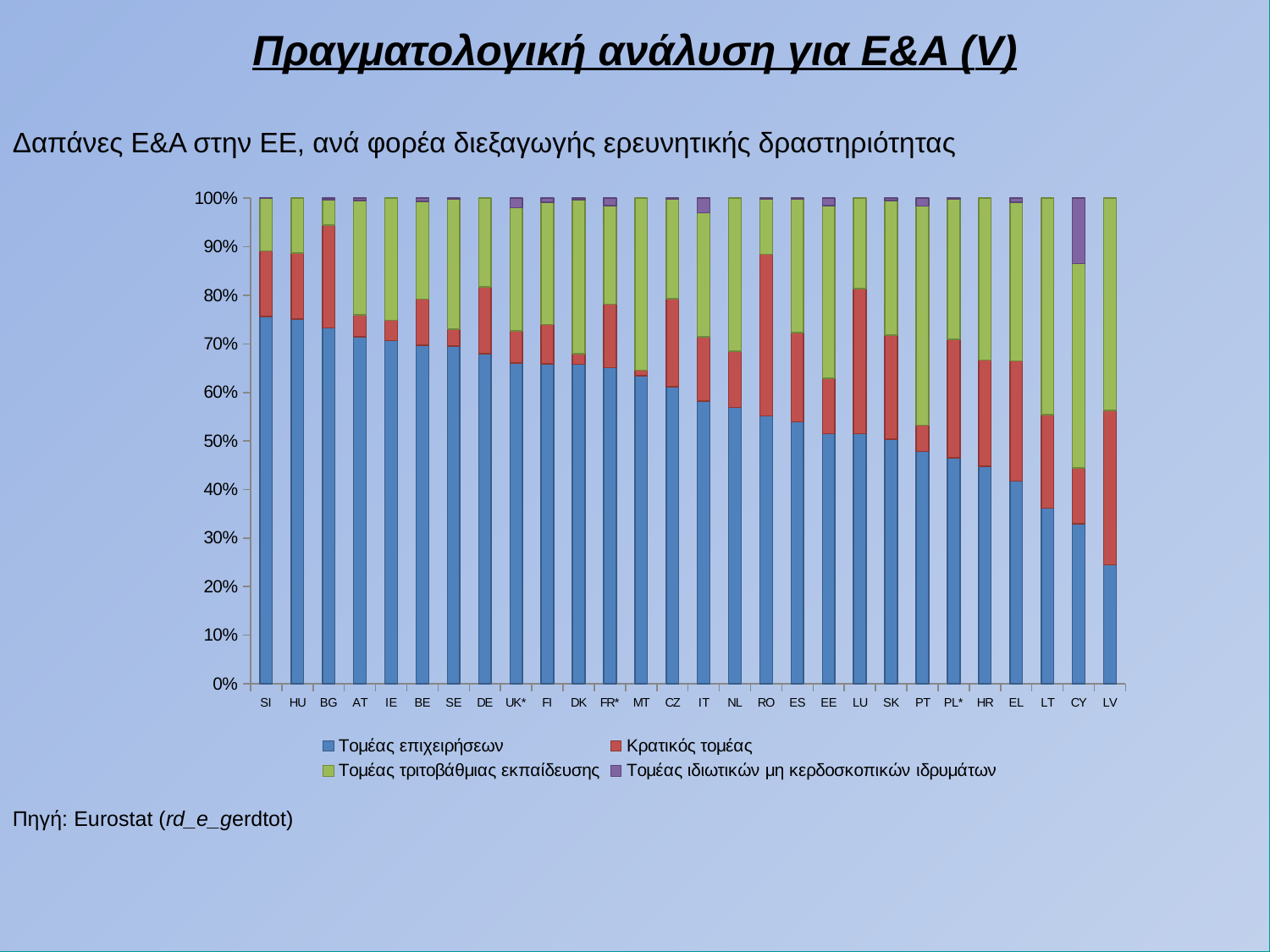
What type of chart is shown on the slide? Stacked bar chart Does the share for Τομέας επιχειρήσεων generally rise or fall from left to right along the x axis? fall Is the value for Τομέας επιχειρήσεων for LT greater or less than 40%? less Which colour represents Κρατικός τομέας in the legend? Red Which country has the lowest share for Τομέας επιχειρήσεων? LV What does each stacked bar total? 100% Which has a larger share for Τομέας επιχειρήσεων, SI or LV? SI Is the value for Τομέας επιχειρήσεων for SI greater or less than 70%? greater How many series does the legend list? 4 Is the value for Τομέας επιχειρήσεων for LV greater or less than 30%? less How many countries are shown on the x axis? 28